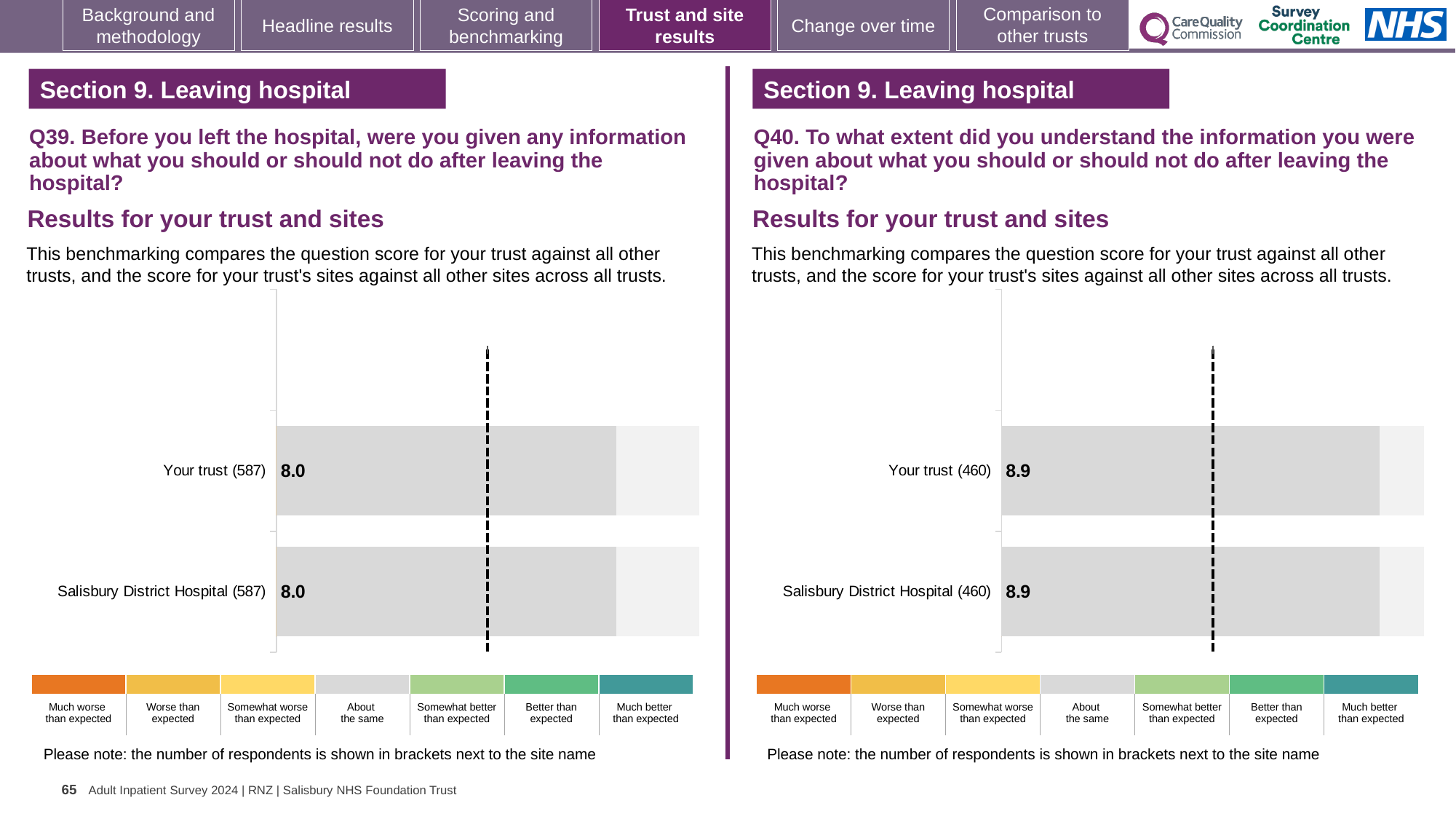
In the Q40 chart on the right, how many respondents are shown in brackets next to Salisbury District Hospital? 460 How many categories does the colour legend below the Q39 chart on the left list? 7 How many bars are plotted in the Q39 chart on the left? 2 In the Q39 chart on the left, what is the score for Your trust? 8.0 In the Q39 chart on the left, what is the difference between the score for Your trust and the score for Salisbury District Hospital? 0.0 How many bars are plotted in the Q40 chart on the right? 2 In the Q39 chart on the left, how many respondents are shown in brackets next to Your trust? 587 In the Q40 chart on the right, what is the difference between the score for Your trust and the score for Salisbury District Hospital? 0.0 In the Q40 chart on the right, what is the score for Your trust? 8.9 What kind of chart is used for the Q40 results on the right? Bar chart In the Q40 chart on the right, what is the score for Salisbury District Hospital? 8.9 In the Q39 chart on the left, what is the score for Salisbury District Hospital? 8.0